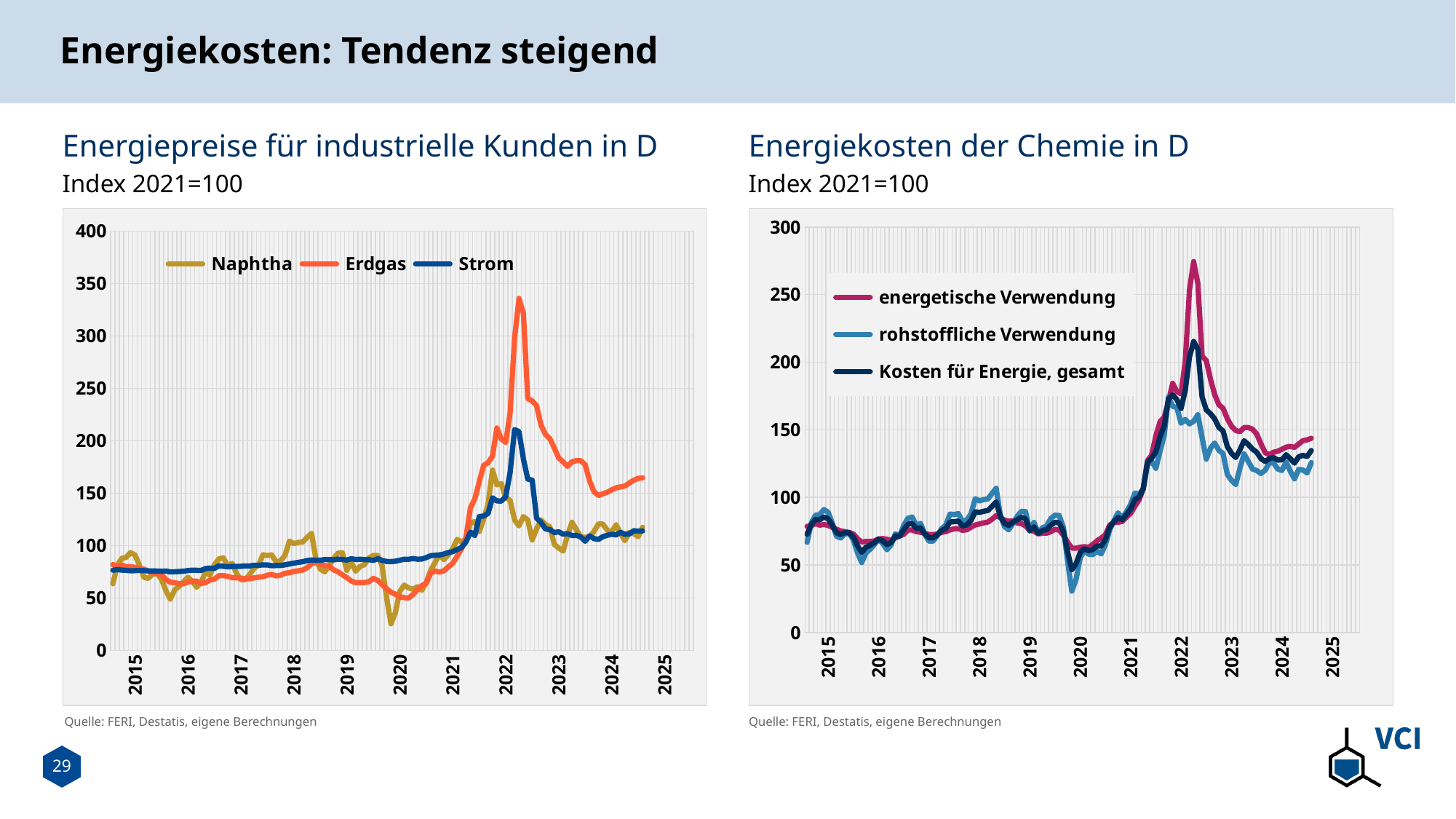
In the left chart 'Energiepreise für industrielle Kunden in D', is the peak value of Erdgas in 2022 greater or less than 300? greater In the right chart 'Energiekosten der Chemie in D', which series reaches the highest peak in 2022? energetische Verwendung How many series does the legend of the left chart 'Energiepreise für industrielle Kunden in D' list? 3 How many series does the legend of the right chart 'Energiekosten der Chemie in D' list? 3 Which series are listed in the legend of the right chart 'Energiekosten der Chemie in D'? energetische Verwendung, rohstoffliche Verwendung, Kosten für Energie, gesamt In the right chart 'Energiekosten der Chemie in D', is the peak value of energetische Verwendung in 2022 greater or less than 250? greater In the right chart 'Energiekosten der Chemie in D', is the lowest value of rohstoffliche Verwendung around 2020 greater or less than 50? less What kind of chart is the left chart, 'Energiepreise für industrielle Kunden in D'? line chart In the left chart 'Energiepreise für industrielle Kunden in D', which series reaches the highest peak in 2022? Erdgas Which series are listed in the legend of the left chart 'Energiepreise für industrielle Kunden in D'? Naphtha, Erdgas, Strom